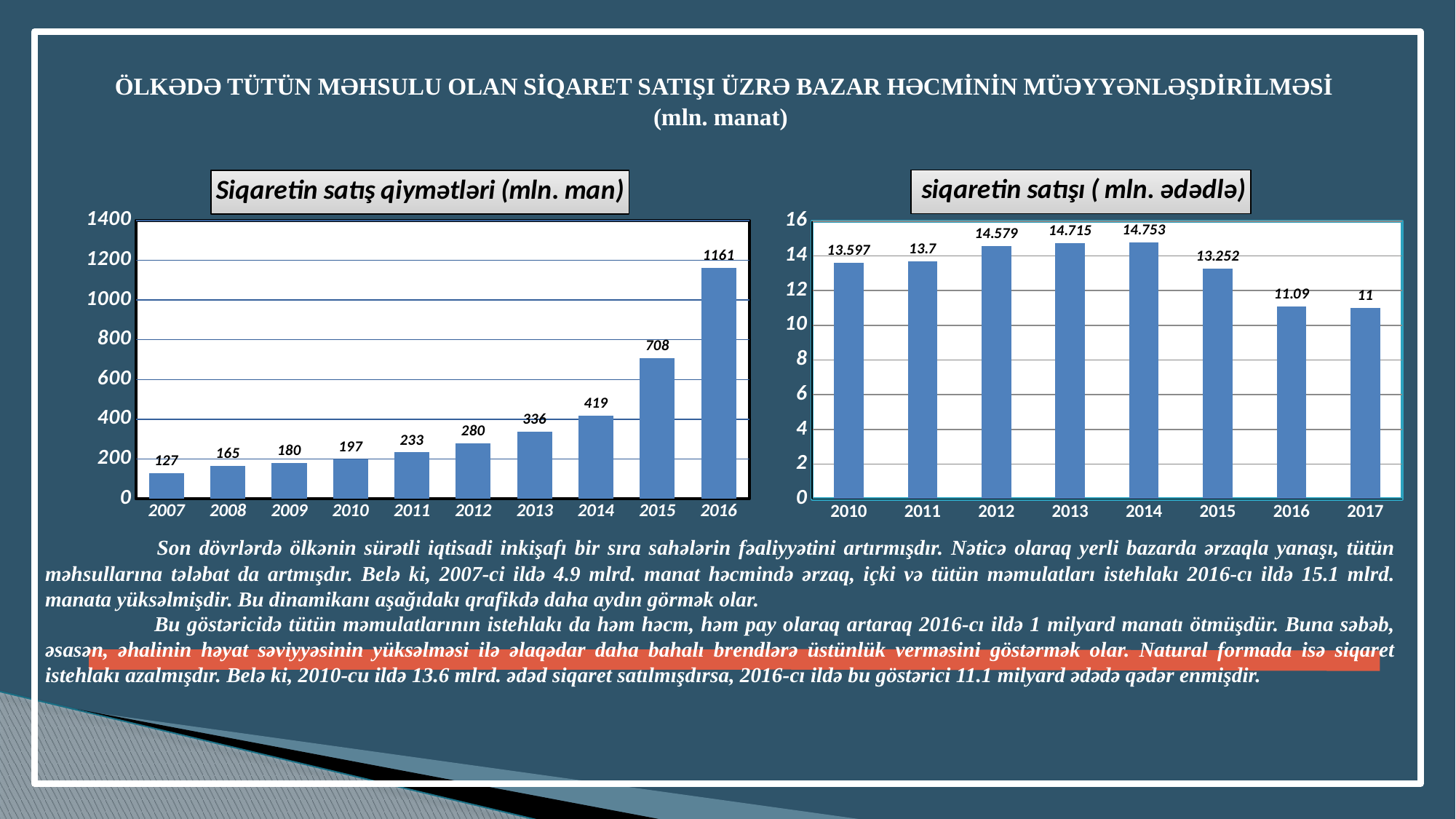
In the chart titled "siqaretin satışı ( mln. ədədlə)", what is the value for 2017? 11 In the chart titled "Siqaretin satış qiymətləri (mln. man)", do the values rise or fall from 2007 to 2016? rise In the chart titled "Siqaretin satış qiymətləri (mln. man)", what is the value for 2011? 233 In the chart titled "siqaretin satışı ( mln. ədədlə)", what is the value for 2014? 14.753 In the chart titled "siqaretin satışı ( mln. ədədlə)", how many years are shown? 8 In the chart titled "Siqaretin satış qiymətləri (mln. man)", what is the value for 2016? 1161 In the chart titled "siqaretin satışı ( mln. ədədlə)", which is larger, the value for 2012 or the value for 2015? 2012 In the chart titled "Siqaretin satış qiymətləri (mln. man)", what is the difference between the values for 2016 and 2015? 453 What kind of chart is the chart titled "siqaretin satışı ( mln. ədədlə)"? bar chart In the chart titled "siqaretin satışı ( mln. ədədlə)", which year has the highest value? 2014 In the chart titled "Siqaretin satış qiymətləri (mln. man)", how many years are shown? 10 In the chart titled "Siqaretin satış qiymətləri (mln. man)", which year has the lowest value? 2007